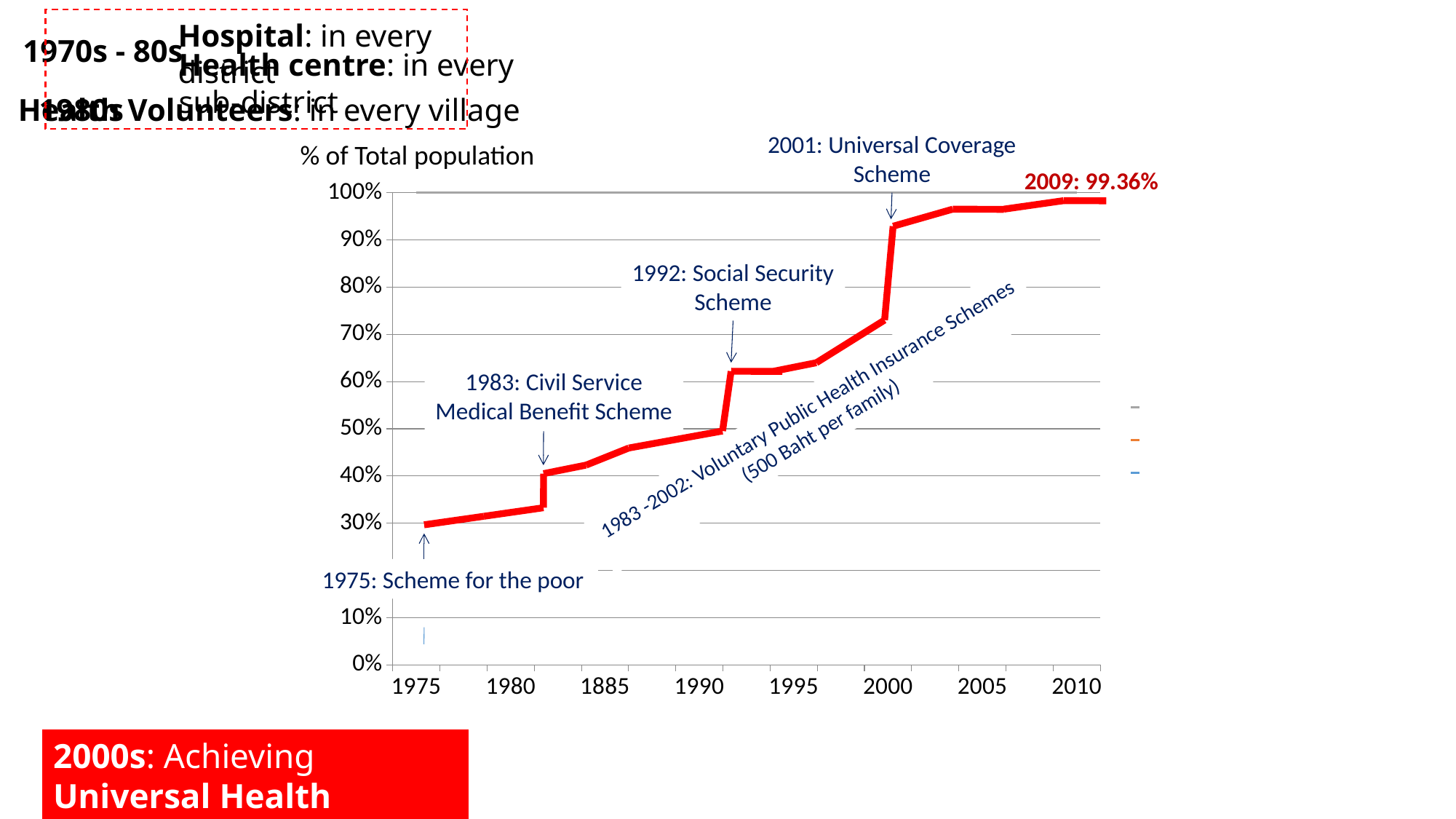
Is the value for 1975 greater or less than 40%? less What is the label shown above the y axis of the chart? % of Total population What kind of chart is shown on the slide? line chart Which year has the lowest value on the chart? 1975 What value is printed for 2009 on the chart? 99.36% Is the value for 2000 greater or less than 80%? less Is the value for 1990 greater or less than 60%? less Which scheme is annotated on the chart at 2001? Universal Coverage Scheme Do the values rise or fall along the x axis from 1975 to 2010? rise